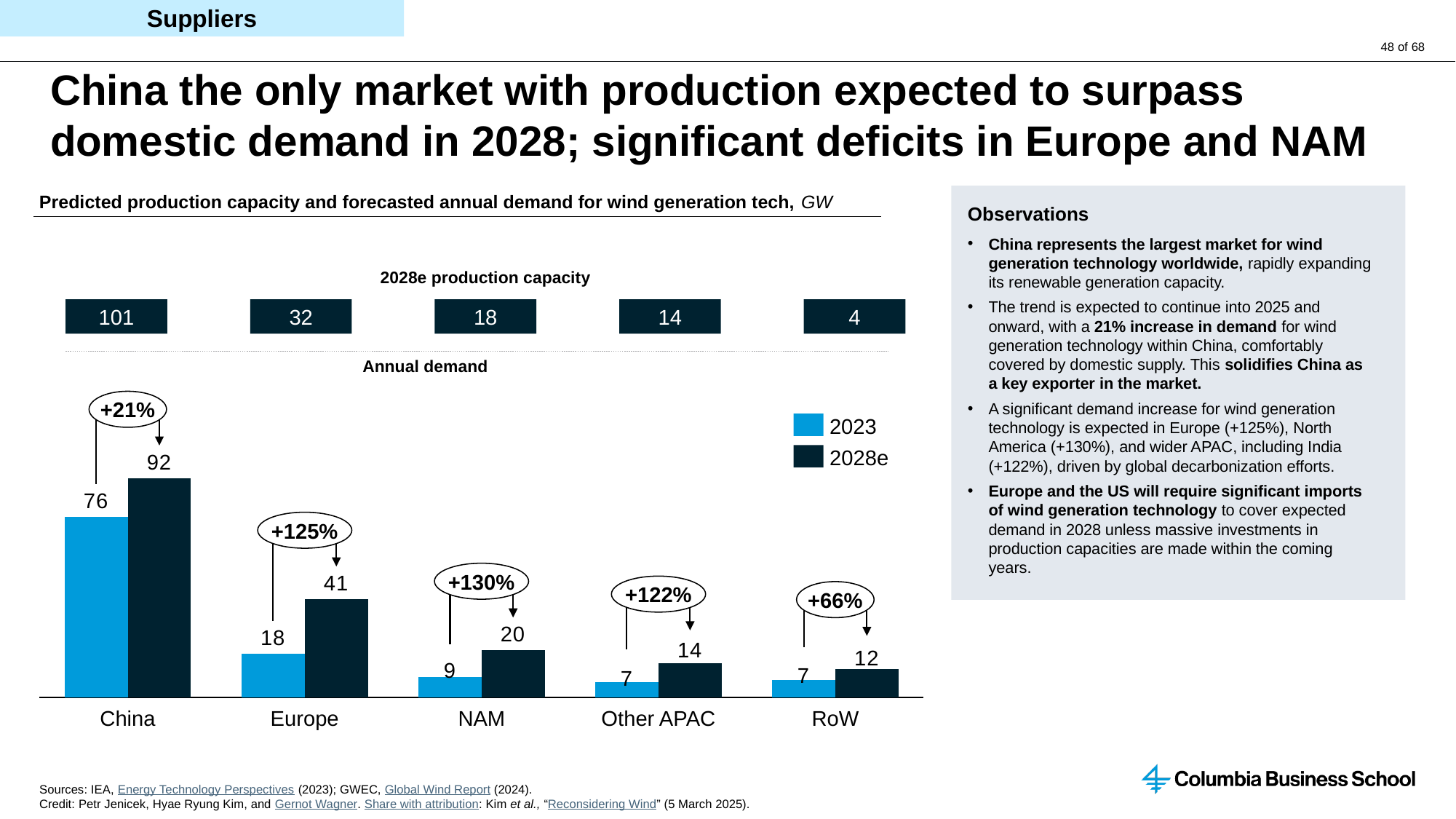
Which is larger: the 2028e demand for NAM or the 2028e demand for Other APAC? NAM Which region has the highest 2028e annual demand? China How many series does the legend of the annual demand chart list? 2 What is the 2023 annual demand for China? 76 What is the 2028e production capacity shown for NAM? 18 What unit is given in the chart title? GW What is the difference between China's 2028e demand and its 2023 demand? 16 What percentage increase in demand is shown for Europe between 2023 and 2028e? +125% What is the 2028e annual demand for Europe? 41 What kind of chart is used to show annual demand? Bar chart How many regions are shown on the x axis of the annual demand chart? 5 Which region has the lowest 2028e production capacity? RoW